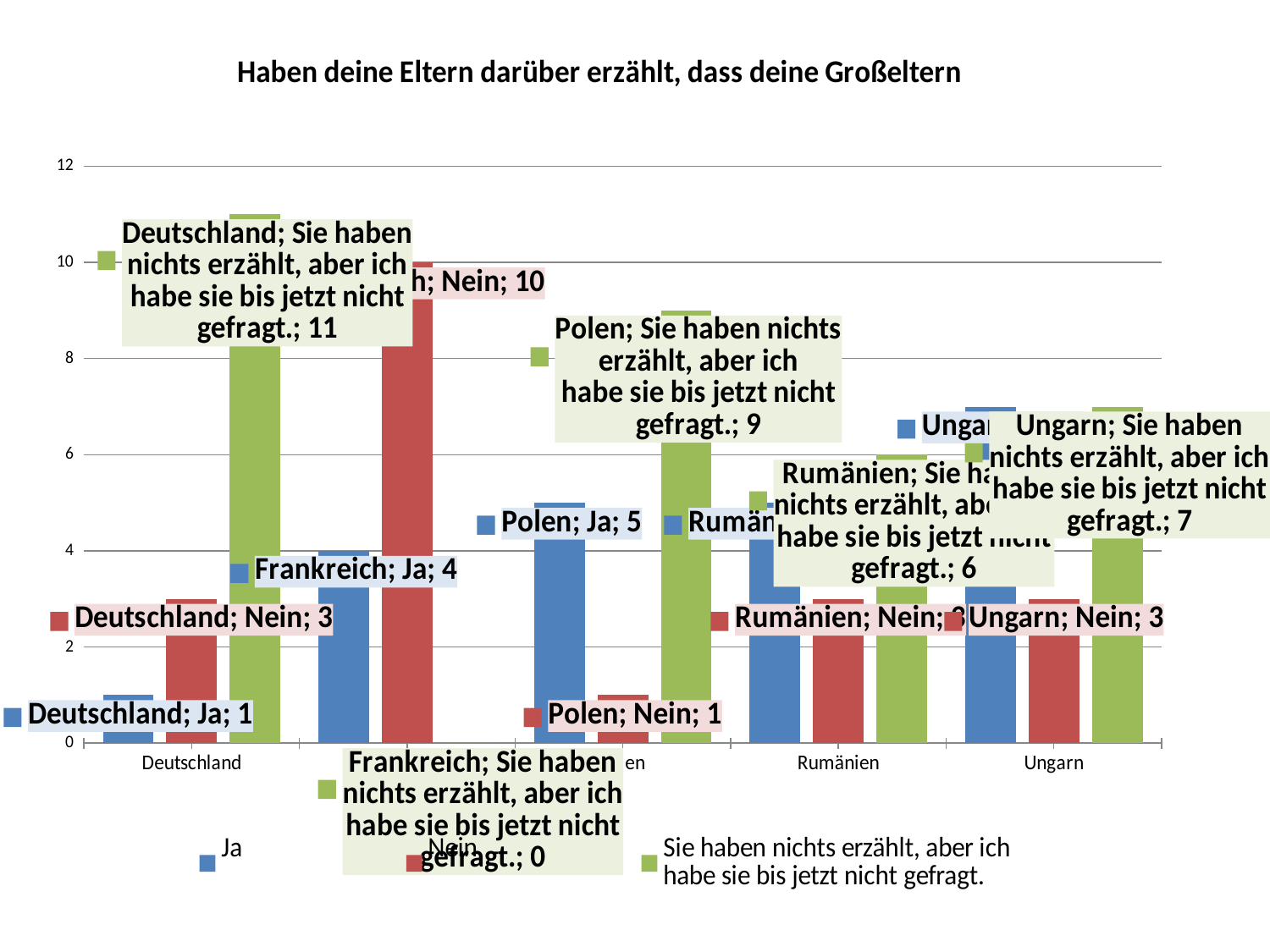
Which country has the lowest value for 'Ja'? Deutschland What is the value for 'Sie haben nichts erzählt, aber ich habe sie bis jetzt nicht gefragt.' for Frankreich? 0 How many countries are shown on the x axis of the chart? 5 What is the difference between the 'Ja' value and the 'Nein' value for Polen? 4 What is the value for 'Sie haben nichts erzählt, aber ich habe sie bis jetzt nicht gefragt.' for Deutschland? 11 Which country has the highest value for 'Sie haben nichts erzählt, aber ich habe sie bis jetzt nicht gefragt.'? Deutschland Is the value for 'Ja' for Ungarn greater or less than 6? greater How many series does the legend of the chart list? 3 What is the value for 'Ja' for Polen? 5 What is the value for 'Ja' for Deutschland? 1 What is the value for 'Sie haben nichts erzählt, aber ich habe sie bis jetzt nicht gefragt.' for Rumänien? 6 What kind of chart is shown on the slide? bar chart